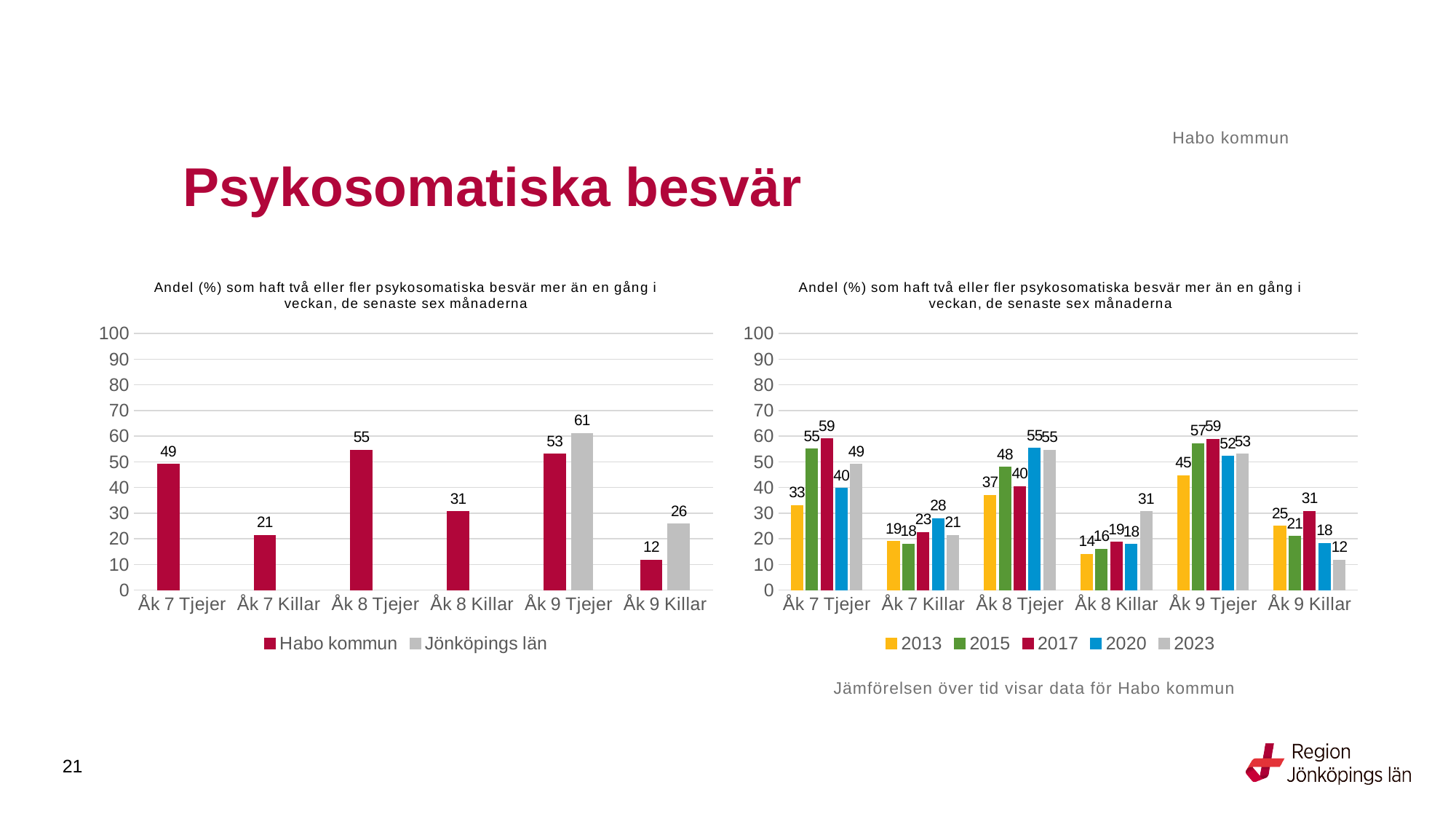
In the right chart, what is the difference between the 2015 and 2013 values for Åk 7 Tjejer? 22 In the right chart, what is the value for 2013 for Åk 9 Tjejer? 45 What kind of chart is the right chart? Bar chart In the left chart, which category has the lowest value for Habo kommun? Åk 9 Killar In the left chart, how many series does the legend list? 2 In the right chart, which is larger for Åk 9 Killar: the value for 2013 or the value for 2023? 2013 In the right chart, what is the value for 2023 for Åk 8 Killar? 31 In the left chart, what is the difference between Jönköpings län and Habo kommun for Åk 9 Killar? 14 In the left chart, what is the value for Habo kommun for Åk 8 Tjejer? 55 In the right chart, which year has the highest value for Åk 7 Tjejer? 2017 In the right chart, how many series does the legend list? 5 In the left chart, what is the value for Jönköpings län for Åk 9 Tjejer? 61